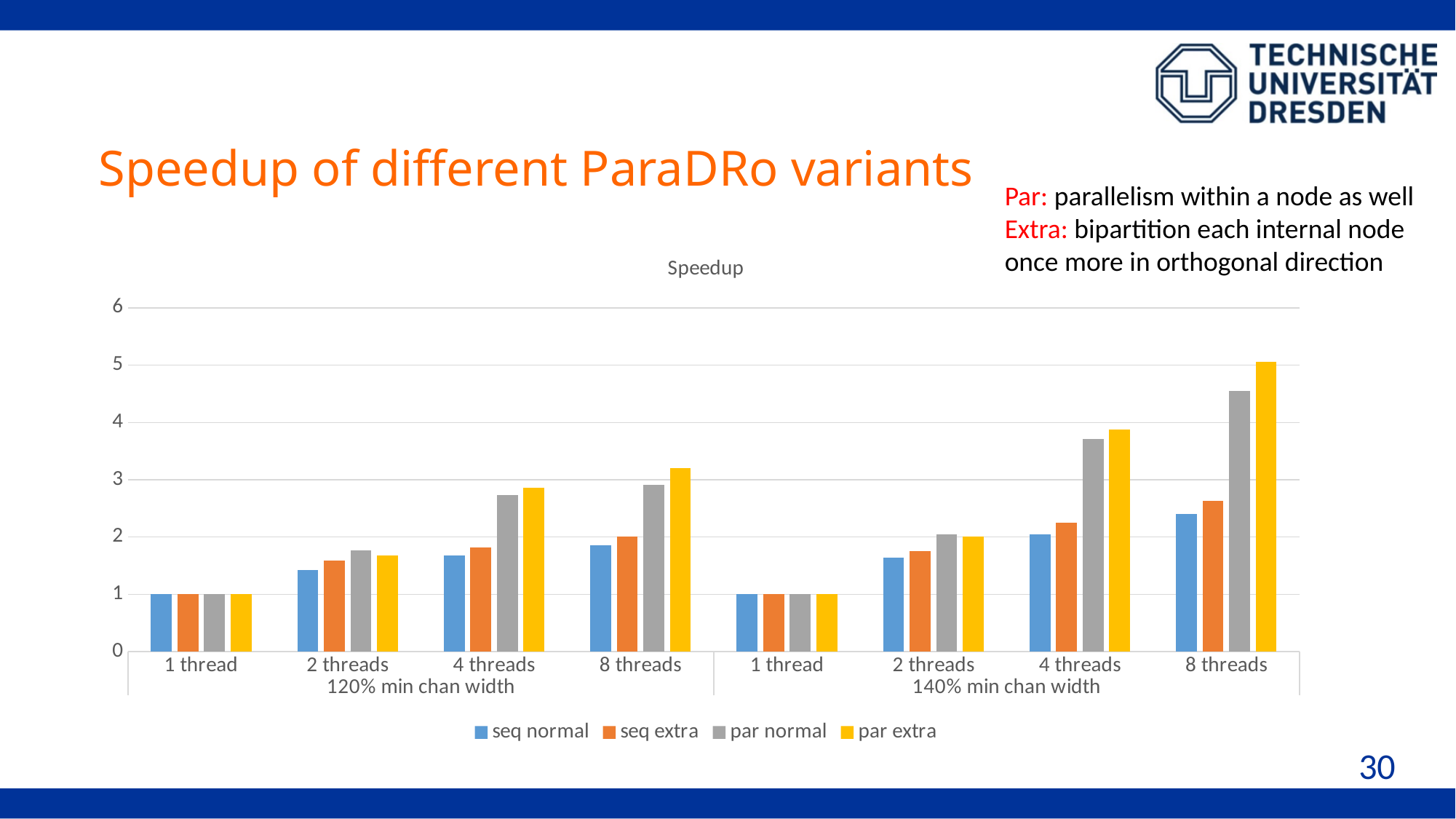
What is the speedup of par extra at 1 thread for 140% min chan width? 1 For 140% min chan width, does the speedup of par extra rise or fall as the number of threads increases? rises Is the speedup of par extra at 4 threads for 120% min chan width greater or less than 3? less What is the title of the chart? Speedup What kind of chart is shown on the slide? bar chart What is the speedup of seq normal at 1 thread for 120% min chan width? 1 How many thread-count categories are plotted along the x axis in total? 8 Is the speedup of seq normal at 8 threads for 120% min chan width greater or less than 2? less Which series and category has the highest speedup in the chart? par extra at 8 threads, 140% min chan width Is the speedup of par extra at 8 threads for 140% min chan width greater or less than 4? greater At 8 threads for 120% min chan width, which is larger: seq normal or par normal? par normal How many series does the legend list? 4